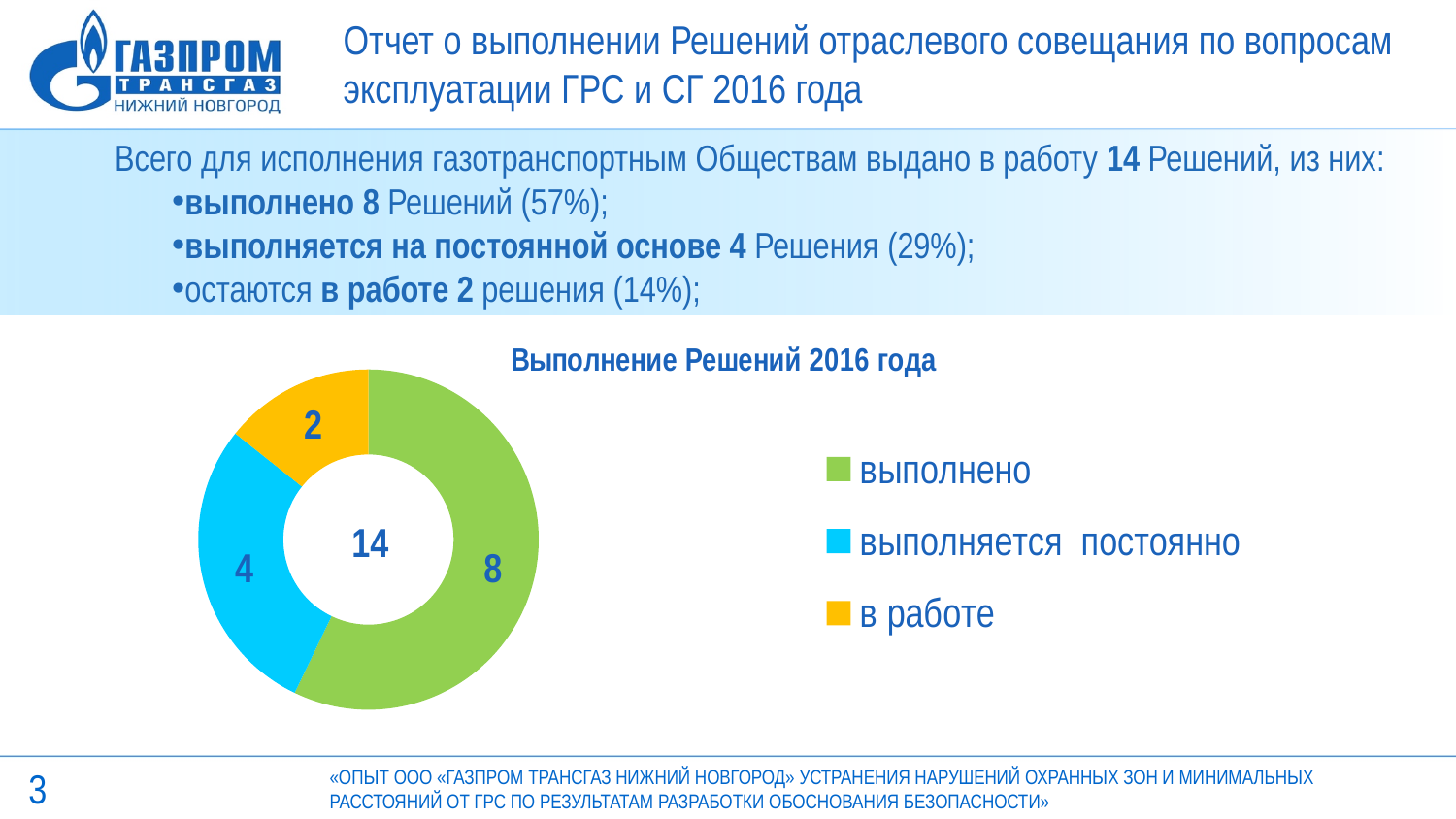
What is the value for "выполняется постоянно"? 4 What is the value for "выполнено"? 8 Which category has the smallest value? в работе What is the total of all slices shown in the centre of the chart? 14 What is the difference between the values for "выполнено" and "выполняется постоянно"? 4 Which category has the largest value? выполнено Which is larger, the value for "выполняется постоянно" or the value for "в работе"? выполняется постоянно What is the value for "в работе"? 2 What share of the total does the "выполнено" slice represent? 57% What type of chart is shown on the slide? doughnut chart What is the title of the chart? Выполнение Решений 2016 года How many categories does the chart show? 3